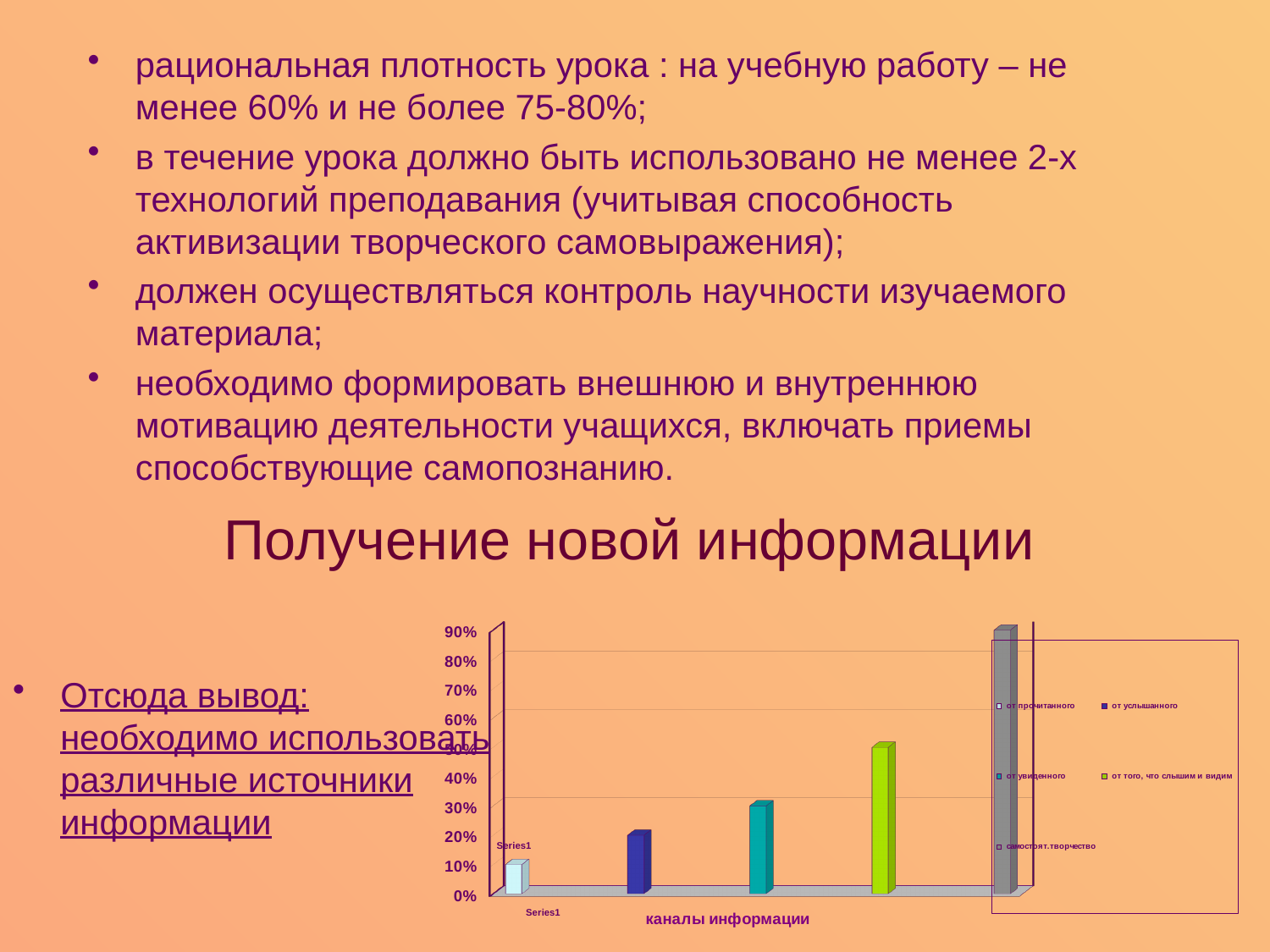
Is the value for 'от того, что слышим и видим' greater or less than 40%? greater Which legend category has the shortest bar in the chart? от прочитанного How many entries does the chart's legend list? 5 Is the value for 'самостоят.творчество' greater or less than 80%? greater Which legend category has the tallest bar in the chart? самостоят.творчество Is the value for 'от прочитанного' greater or less than 20%? less What kind of chart is shown under the heading 'Получение новой информации'? bar chart Which bar is taller: 'от услышанного' or 'от увиденного'? от увиденного Do the bar values rise or fall from left to right across the chart? rise How many bars are plotted in the chart? 5 What is the title of the chart's horizontal axis? каналы информации